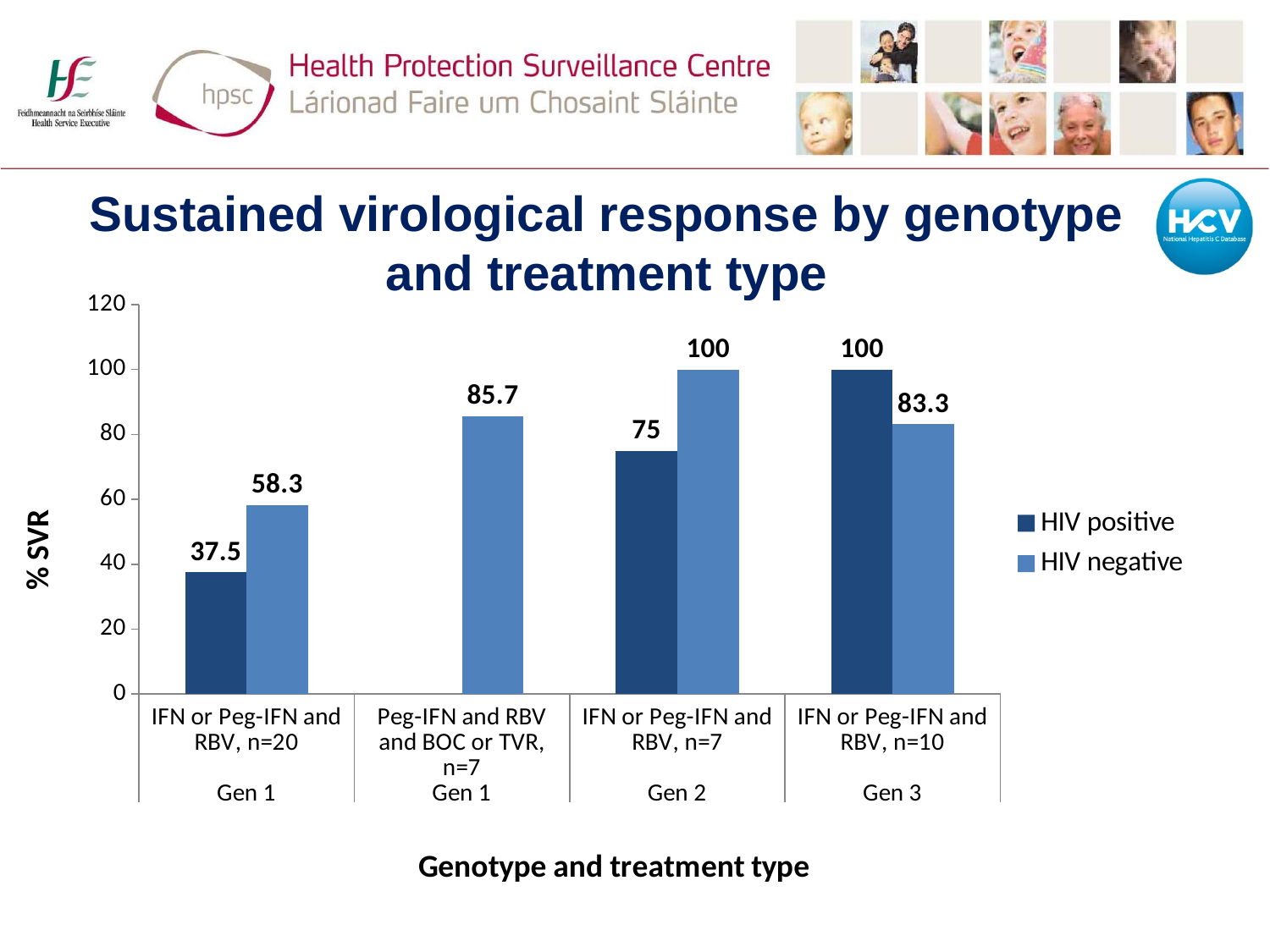
For Gen 2, which group has the higher % SVR, HIV positive or HIV negative? HIV negative Which category has the lowest % SVR for HIV negative patients? Gen 1, IFN or Peg-IFN and RBV, n=20 How many genotype and treatment type categories are shown on the x axis? 4 What is the difference in % SVR between HIV positive and HIV negative patients for Gen 3? 16.7 What is the % SVR for HIV positive patients with Gen 1 treated with IFN or Peg-IFN and RBV, n=20? 37.5 How many series does the legend list? 2 What is the difference in % SVR between HIV negative and HIV positive patients for Gen 1 treated with IFN or Peg-IFN and RBV, n=20? 20.8 What is the % SVR for HIV positive patients with Gen 3 treated with IFN or Peg-IFN and RBV, n=10? 100 What is the % SVR for HIV negative patients with Gen 1 treated with Peg-IFN and RBV and BOC or TVR, n=7? 85.7 For Gen 3, which group has the higher % SVR, HIV positive or HIV negative? HIV positive What kind of chart is shown on the slide? Bar chart What is the % SVR for HIV negative patients with Gen 2 treated with IFN or Peg-IFN and RBV, n=7? 100